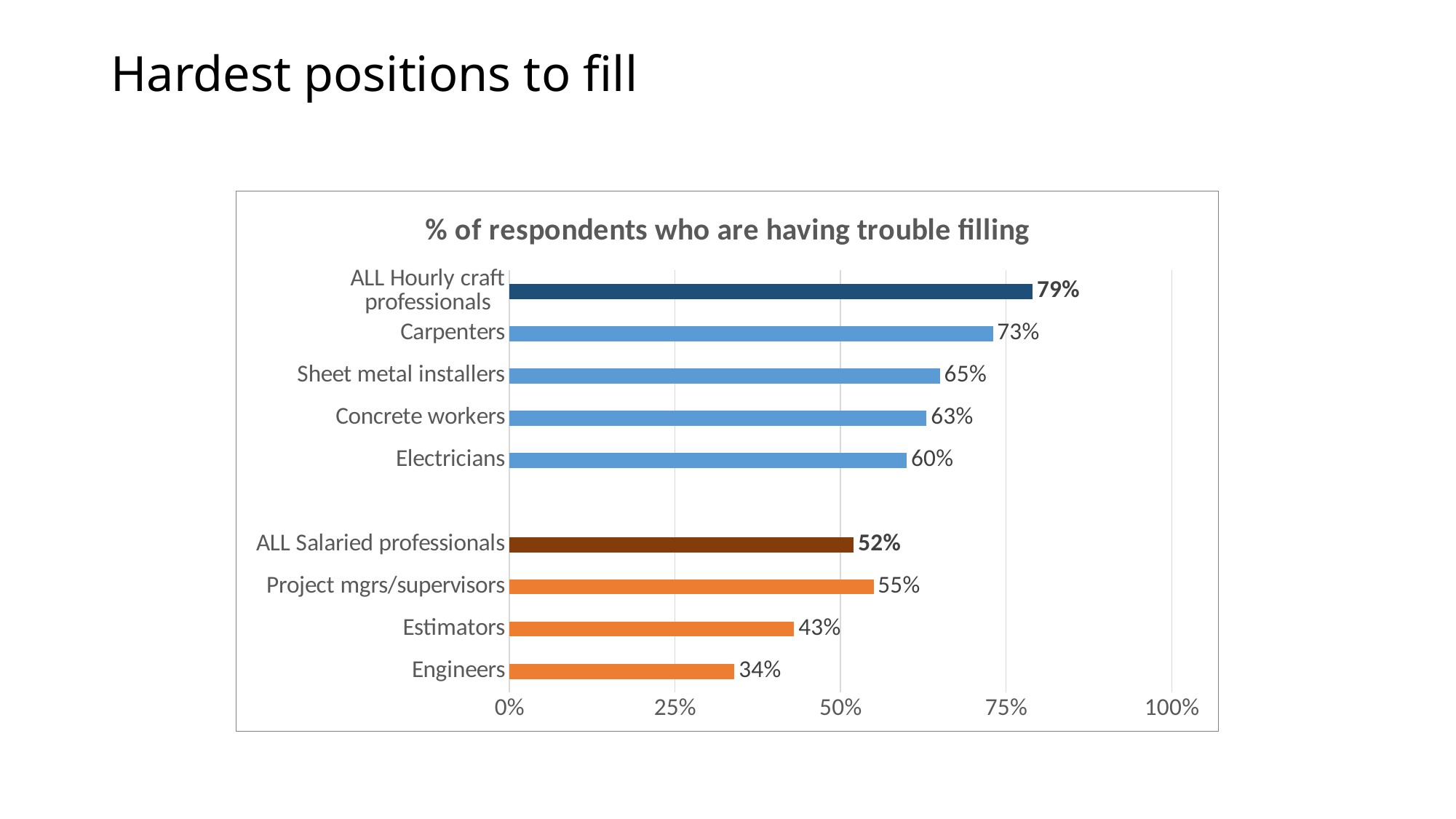
Is the value for Estimators greater or less than 50%? less Which category has the highest value in the chart? ALL Hourly craft professionals What percentage of respondents are having trouble filling Carpenters positions? 73% What kind of chart is shown on the slide? bar chart What is the value shown for Engineers? 34% What is the difference between the values for Carpenters and Electricians? 13% What is the value shown for ALL Salaried professionals? 52% What is the difference between the values for ALL Hourly craft professionals and ALL Salaried professionals? 27% Which category has the lowest value in the chart? Engineers What is the title of the chart? % of respondents who are having trouble filling Which is larger, the value for Sheet metal installers or the value for Project mgrs/supervisors? Sheet metal installers How many categories (bars) are plotted in the chart? 9